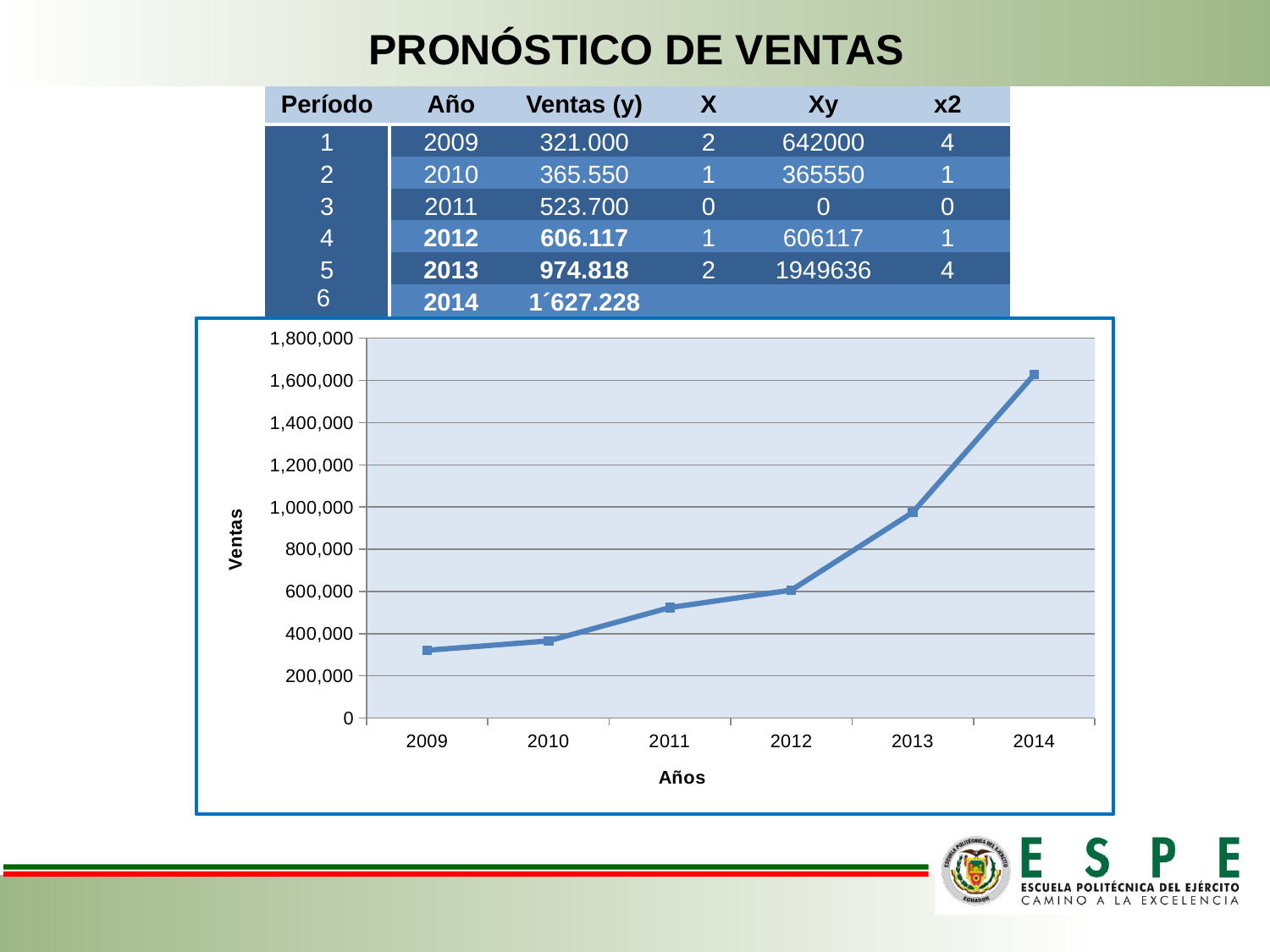
Which year has the larger value, 2010 or 2011? 2011 Do the values in the chart rise or fall from 2009 to 2014? rise What kind of chart is shown on the slide? line chart How many years are plotted along the x axis of the chart? 6 What is the title of the horizontal axis of the chart? Años What is the title of the vertical axis of the chart? Ventas Is the value for 2012 greater or less than 800,000? less Which year has the highest value in the chart? 2014 Is the value for 2013 greater or less than 800,000? greater Is the value for 2014 greater or less than 1,400,000? greater Which year has the lowest value in the chart? 2009